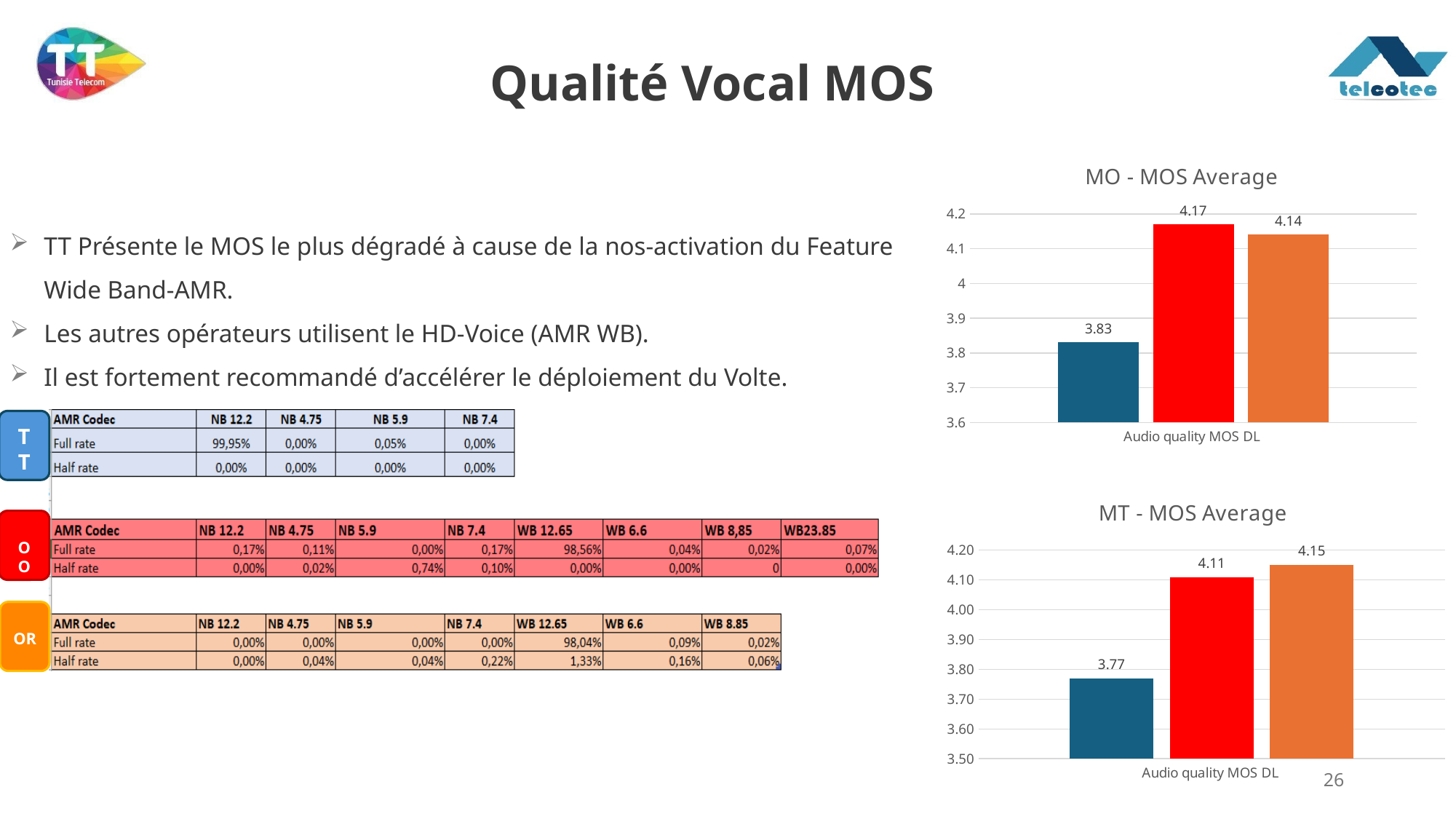
In the MO - MOS Average chart, what is the value of the red (middle) bar? 4.17 In the MO - MOS Average chart, what is the difference between the red bar and the blue bar? 0.34 In the MO - MOS Average chart, which bar has the highest value? The red (middle) bar, 4.17 In the MO - MOS Average chart, what is the value of the blue (leftmost) bar? 3.83 In the MT - MOS Average chart, what is the difference between the orange bar and the blue bar? 0.38 What type of chart is the MO - MOS Average chart? Bar chart In the MT - MOS Average chart, what is the value of the orange (rightmost) bar? 4.15 In the MT - MOS Average chart, what is the value of the blue (leftmost) bar? 3.77 How many bars are plotted in the MT - MOS Average chart? 3 In the MT - MOS Average chart, which bar has the lowest value? The blue (leftmost) bar, 3.77 In the MO - MOS Average chart, is the value of the blue bar greater or less than 3.9? less In the MT - MOS Average chart, which is larger: the red bar or the blue bar? The red bar (4.11)